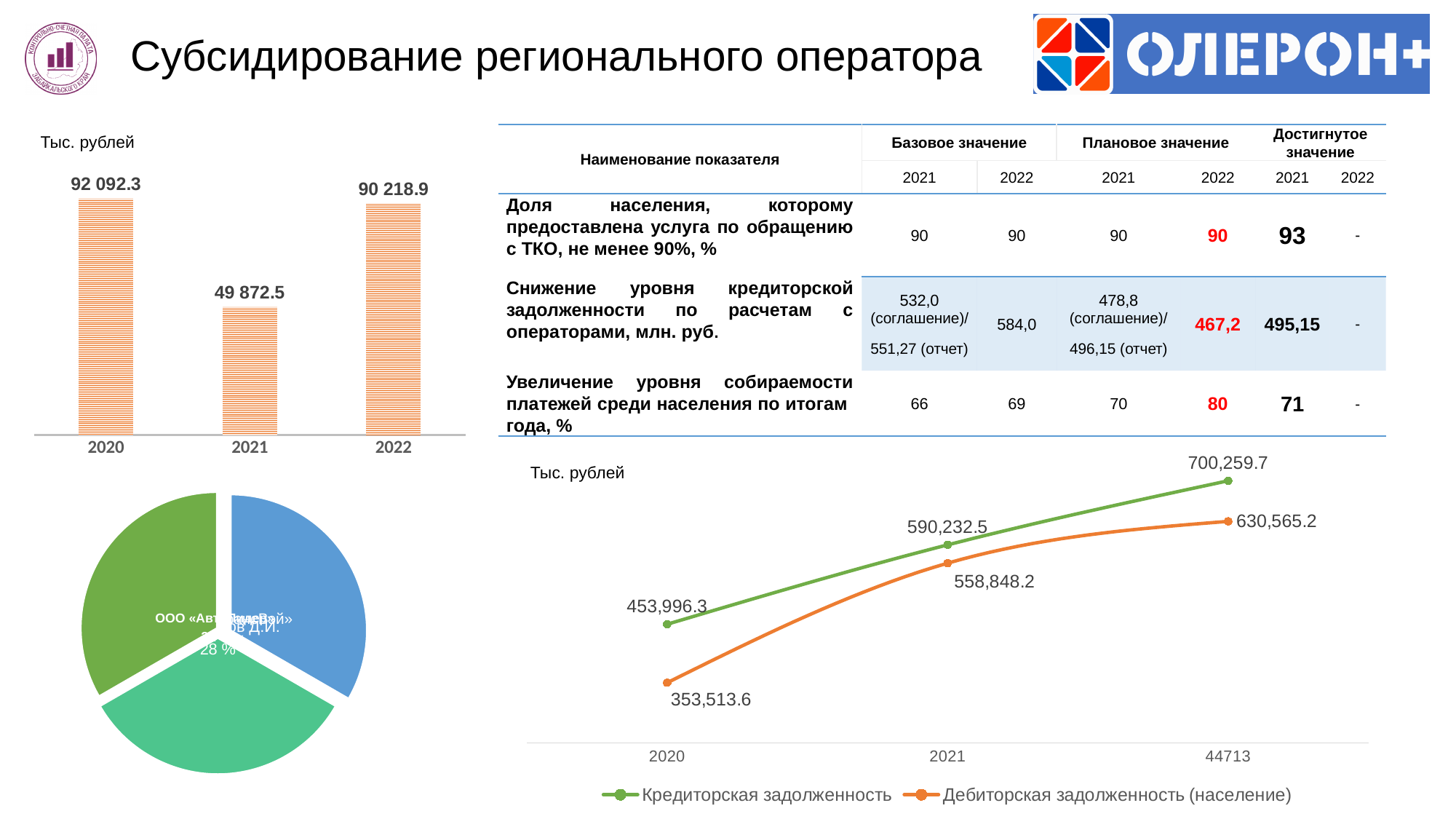
In the bar chart on the left, what is the value for 2020? 92 092.3 In the bar chart on the left, which year has the highest value? 2020 In the bar chart on the left, which year has the lowest value? 2021 In the bar chart on the left, what is the value for 2021? 49 872.5 In the line chart on the right, how many series does the legend list? 2 In the line chart on the right, what is the value of Кредиторская задолженность for 2021? 590,232.5 In the line chart on the right, does Дебиторская задолженность (население) rise or fall from 2020 to the last point? rise In the line chart on the right, what is the value of Дебиторская задолженность (население) for 2020? 353,513.6 In the bar chart on the left, how many bars are shown? 3 In the line chart on the right, which series is higher in 2020: Кредиторская задолженность or Дебиторская задолженность (население)? Кредиторская задолженность In the bar chart on the left, what is the difference between the 2020 and 2022 values? 1 873.4 In the line chart on the right, what is the difference between Кредиторская задолженность and Дебиторская задолженность (население) at the last point (44713)? 69,694.5